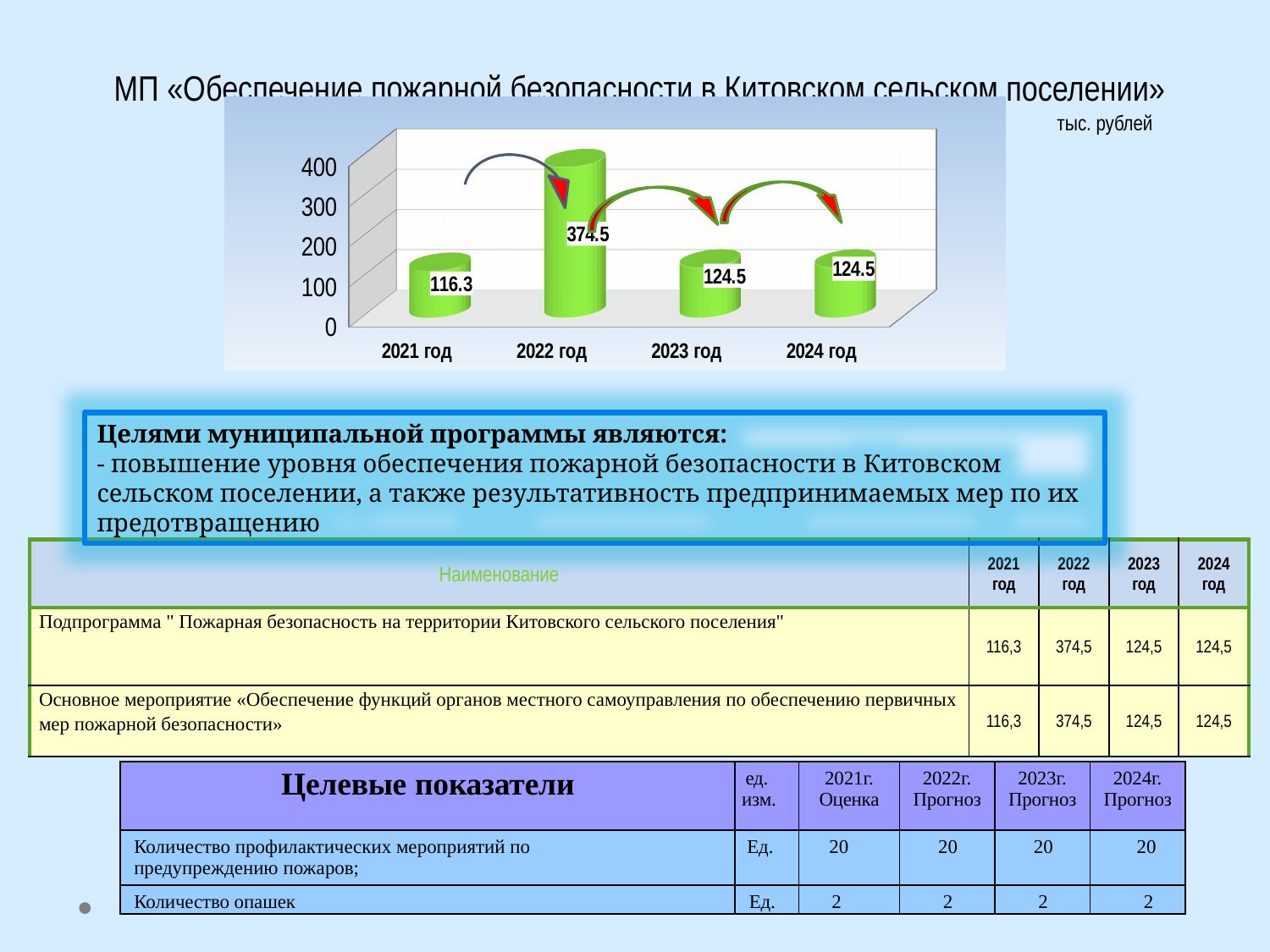
How many years are shown on the x axis of the chart? 4 Which is larger, the value for 2021 год or the value for 2024 год? 2024 год What is the value shown for 2024 год in the chart? 124.5 What is the value shown for 2022 год in the chart? 374.5 What is the value shown for 2023 год in the chart? 124.5 Is the value for 2022 год greater or less than 300? greater What is the difference between the values for 2022 год and 2023 год? 250 Which year has the lowest value in the chart? 2021 год What is the difference between the values for 2023 год and 2021 год? 8.2 What is the value shown for 2021 год in the chart? 116.3 Which year has the highest value in the chart? 2022 год What kind of chart is shown on the slide? bar chart